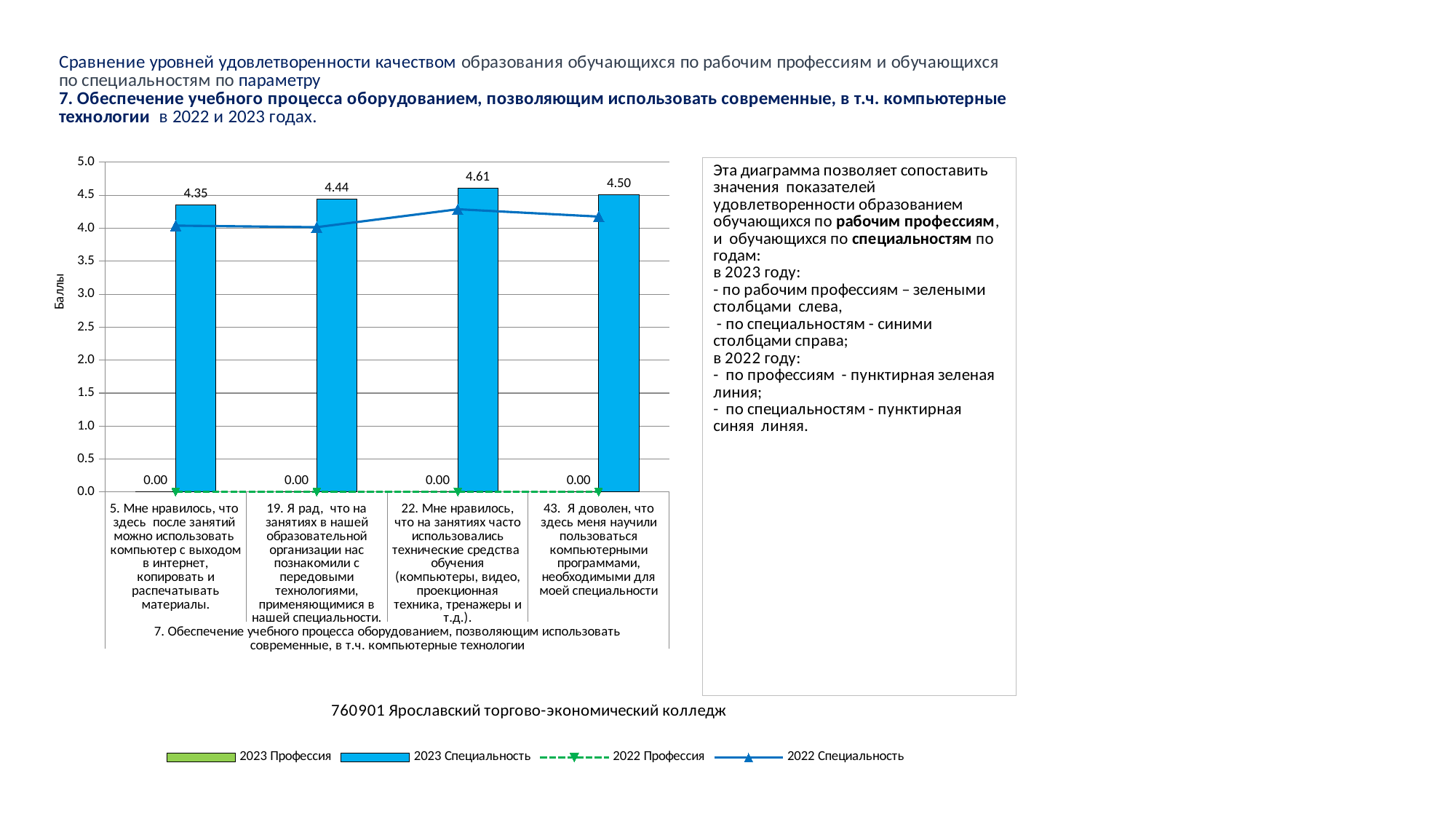
What is the value of the 2023 Профессия series for category 22? 0.00 What is the value of the 2023 Специальность bar for category 43 (Я доволен, что здесь меня научили пользоваться компьютерными программами)? 4.50 What is the difference between the 2023 Специальность values for category 22 and category 5? 0.26 Which is larger: the 2023 Специальность value for category 19 or for category 43? category 43 (4.50) How many categories are shown on the x axis? 4 How many series does the legend list? 4 Which category has the lowest 2023 Специальность value? 5. Мне нравилось, что здесь после занятий можно использовать компьютер с выходом в интернет What is the value of the 2023 Специальность bar for category 5 (Мне нравилось, что здесь после занятий можно использовать компьютер с выходом в интернет)? 4.35 Which category has the highest 2023 Специальность value? 22. Мне нравилось, что на занятиях часто использовались технические средства обучения Is the 2022 Специальность value for category 22 greater or less than 4.0? greater What is the label of the vertical axis? Баллы What is the value of the 2023 Специальность bar for category 19 (Я рад, что на занятиях в нашей образовательной организации нас познакомили с передовыми технологиями)? 4.44